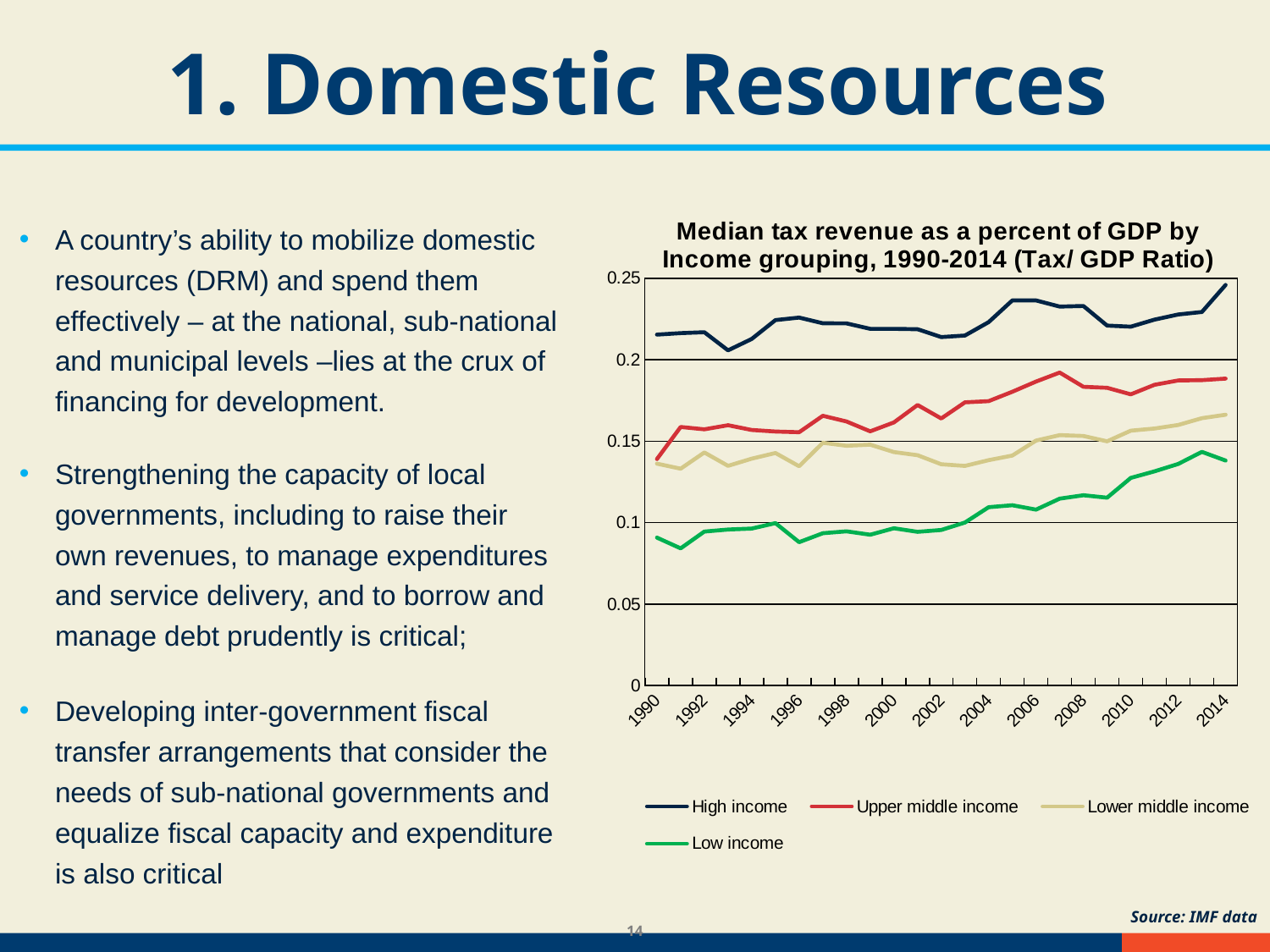
Is the value for Lower middle income in 2014 greater or less than 0.15? greater In 2010, which is larger: the value for Upper middle income or Lower middle income? Upper middle income Is the value for Low income in 1990 greater or less than 0.1? less Which income grouping has the lowest tax/GDP ratio across the whole period? Low income Is the value for High income in 1990 greater or less than 0.2? greater What colour is the line for Low income? green Does the Low income line rise or fall overall from 1990 to 2014? rise Which income grouping has the highest tax/GDP ratio across the whole period? High income What is the title of the chart? Median tax revenue as a percent of GDP by Income grouping, 1990-2014 (Tax/ GDP Ratio) What kind of chart is shown on the slide? line chart How many series does the chart's legend list? 4